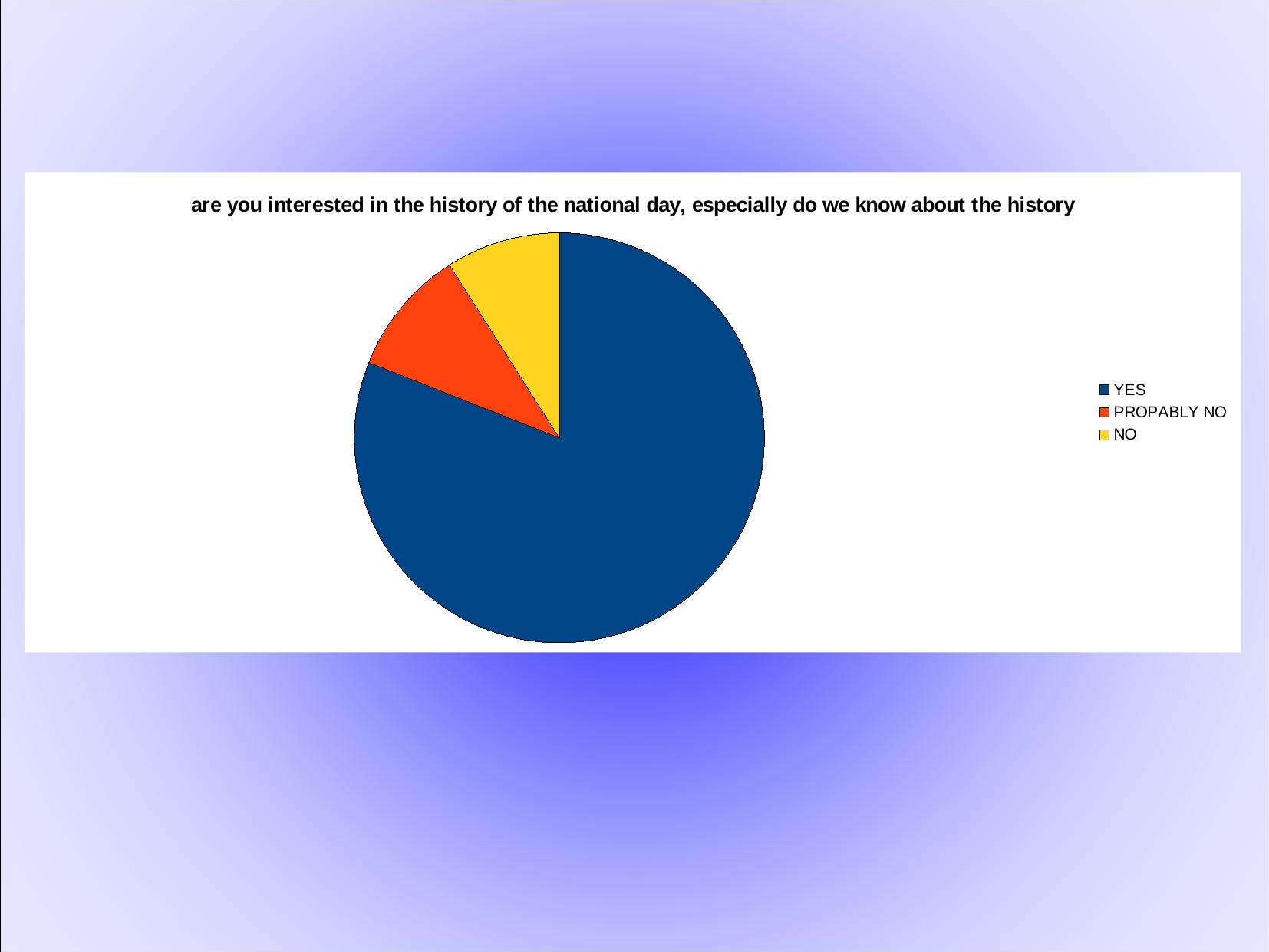
How many entries does the legend of the pie chart list? 3 Which is larger in the pie chart, the slice for YES or the slice for NO? YES How many slices does the pie chart have? 3 Which is larger in the pie chart, the slice for PROPABLY NO or the slice for YES? YES Which category has the largest slice in the pie chart? YES Does the YES slice take up more or less than half of the pie chart? more What colour is the slice for NO in the pie chart? yellow What is the title of the pie chart? are you interested in the history of the national day, especially do we know about the history What kind of chart is shown on the slide? pie chart